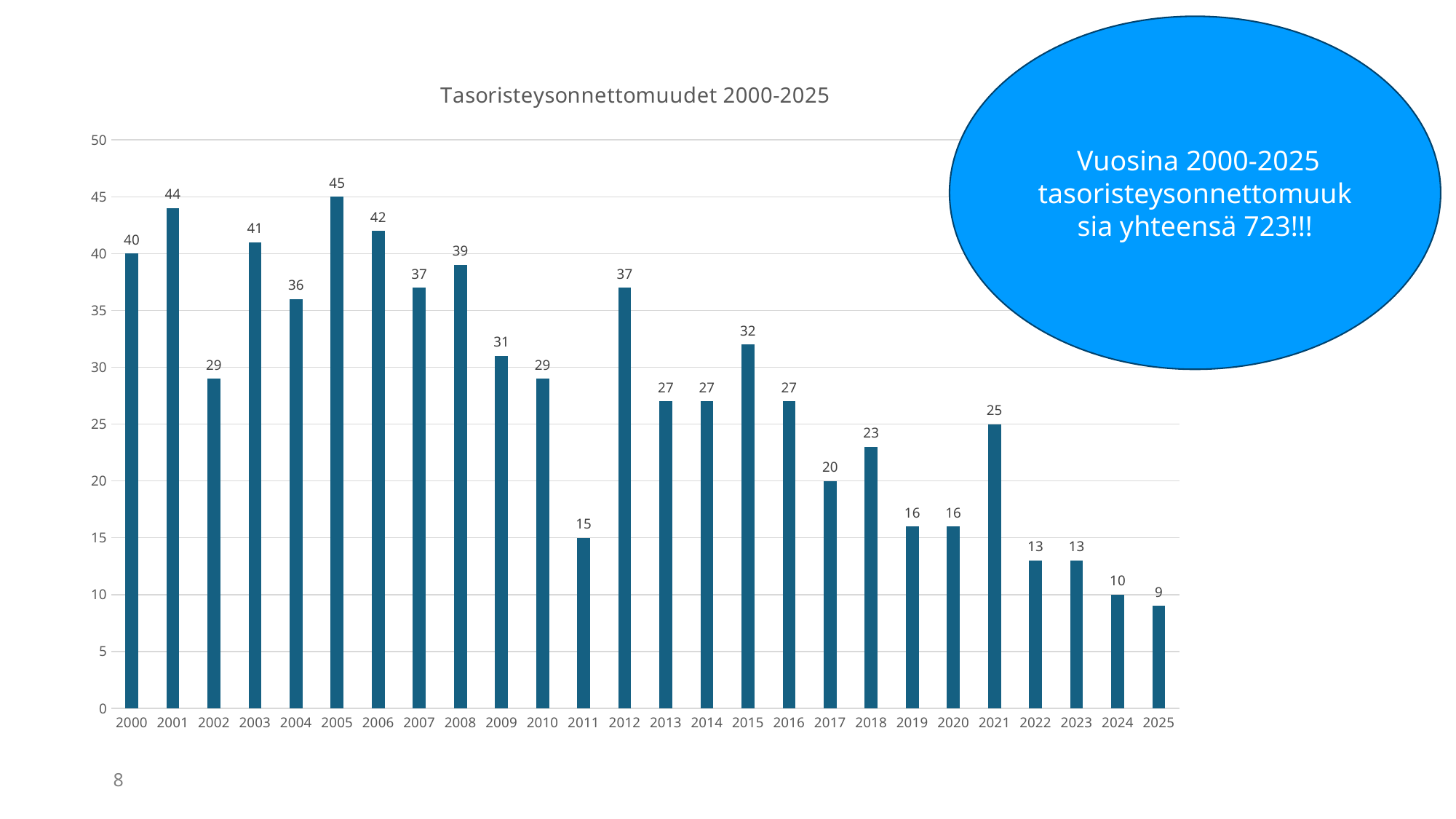
What is the title of the chart? Tasoristeysonnettomuudet 2000-2025 Do the values generally rise or fall from 2000 to 2025? fall What is the difference between the values for 2001 and 2002? 15 What is the value for 2021? 25 What kind of chart is this? bar chart What is the value for 2011? 15 What is the value for 2005? 45 Which year has the highest value? 2005 Which is larger, the value for 2012 or the value for 2015? 2012 Is the value for 2018 greater or less than 25? less Which year has the lowest value? 2025 How many years are shown on the x axis? 26